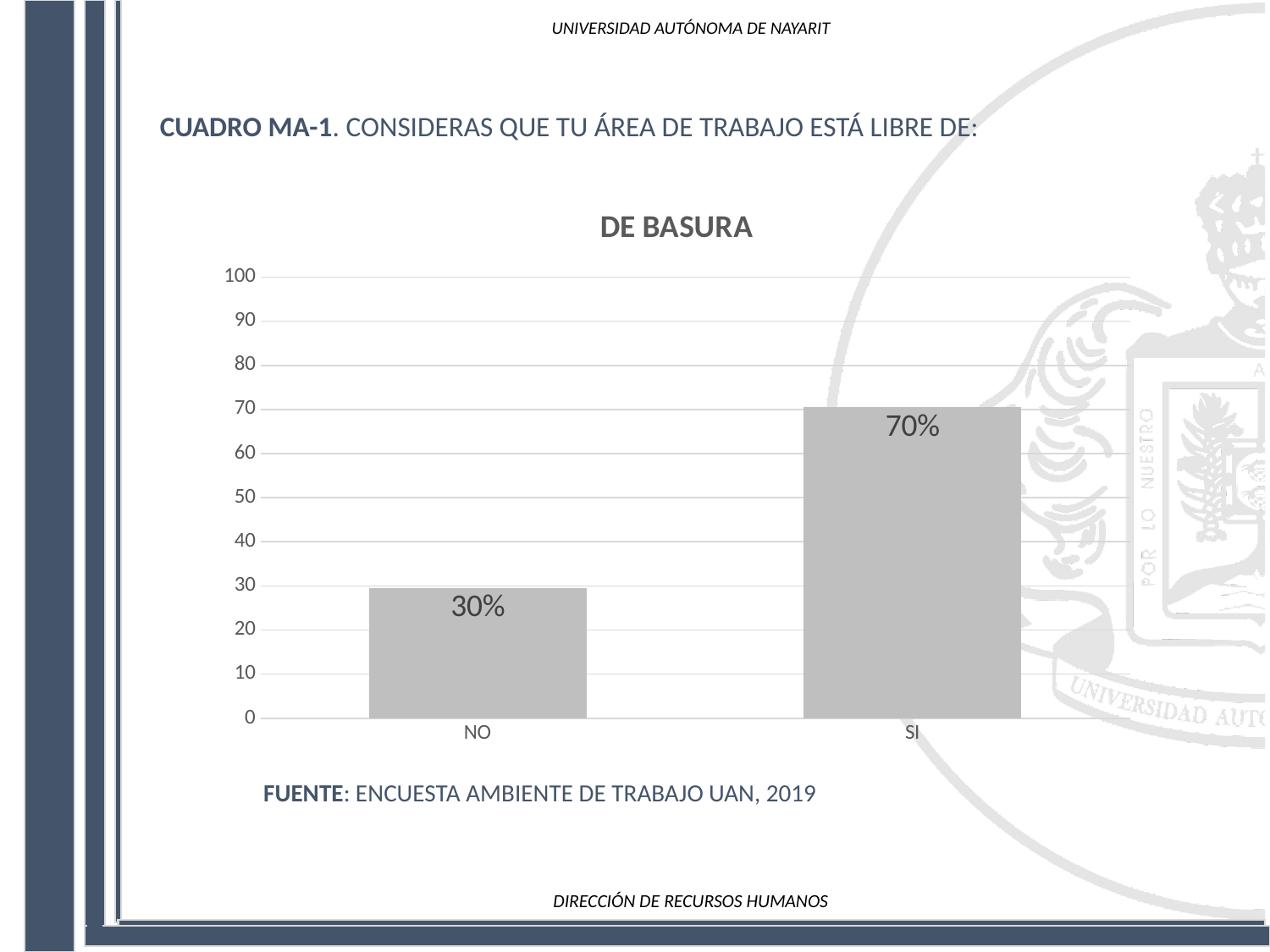
Is the value for NO greater or less than 40? less Which category has the lowest value? NO Is the value for SI greater or less than 60? greater What is the value for NO? 30% What is the title of the chart? DE BASURA How many categories are shown on the x axis? 2 What is the difference between the values for SI and NO? 40% What is the value for SI? 70% What kind of chart is shown? bar chart Which is larger, the value for NO or the value for SI? SI What is the maximum value shown on the vertical axis? 100 Which category has the highest value? SI